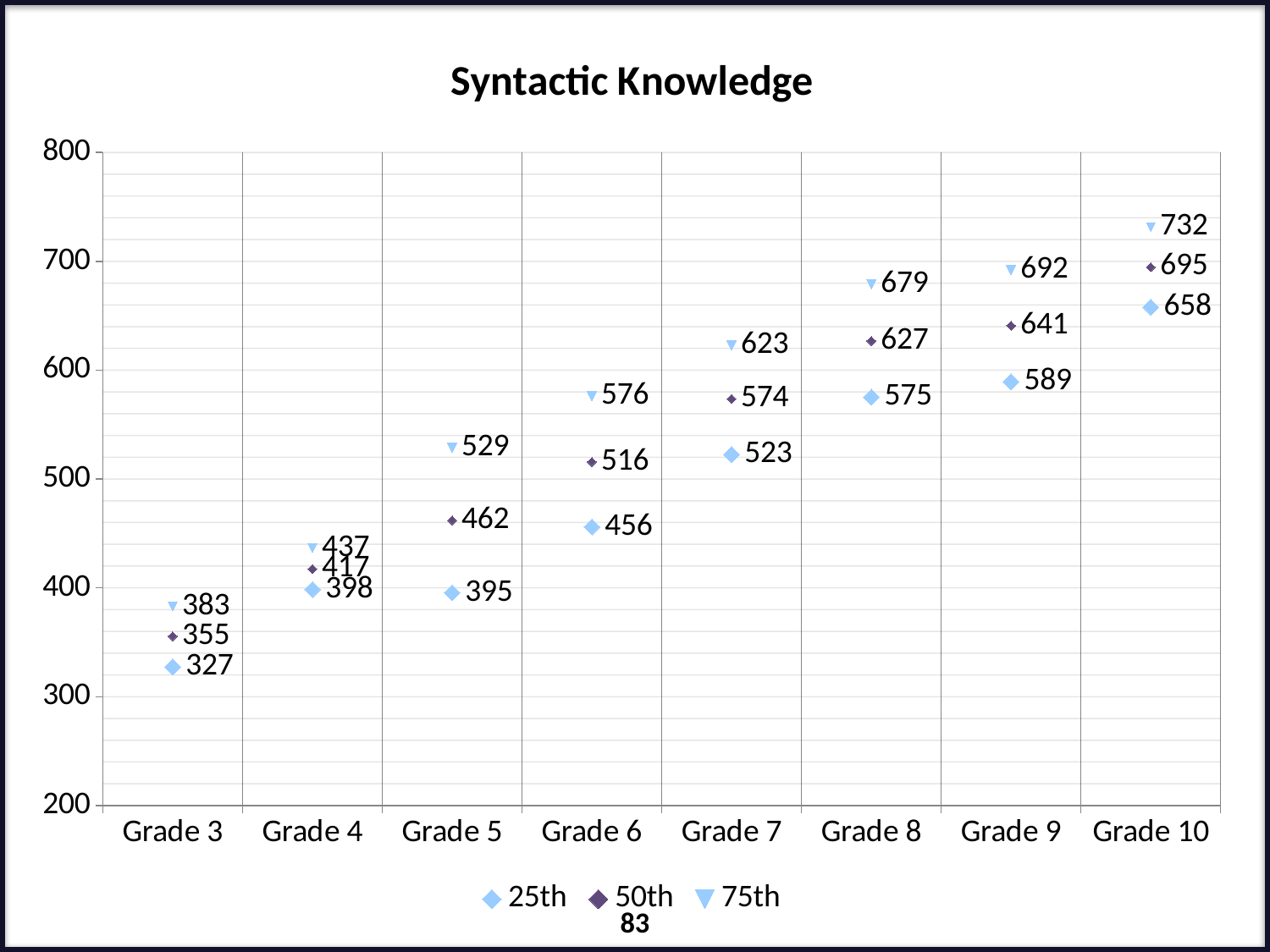
What kind of chart is this? Scatter chart What is the title of the chart? Syntactic Knowledge Which grade has the lowest 75th percentile value? Grade 3 What is the 75th percentile value for Grade 10? 732 Which is larger: the 50th percentile value for Grade 6 or the 25th percentile value for Grade 7? Grade 7 25th percentile (523) What is the difference between the 75th and 25th percentile values for Grade 8? 104 How many series does the legend list? 3 Which grade has the highest 50th percentile value? Grade 10 Do the 25th percentile values rise or fall from Grade 3 to Grade 10? Rise What is the 50th percentile value for Grade 7? 574 What is the 25th percentile value for Grade 3? 327 How many grades are shown on the x axis? 8